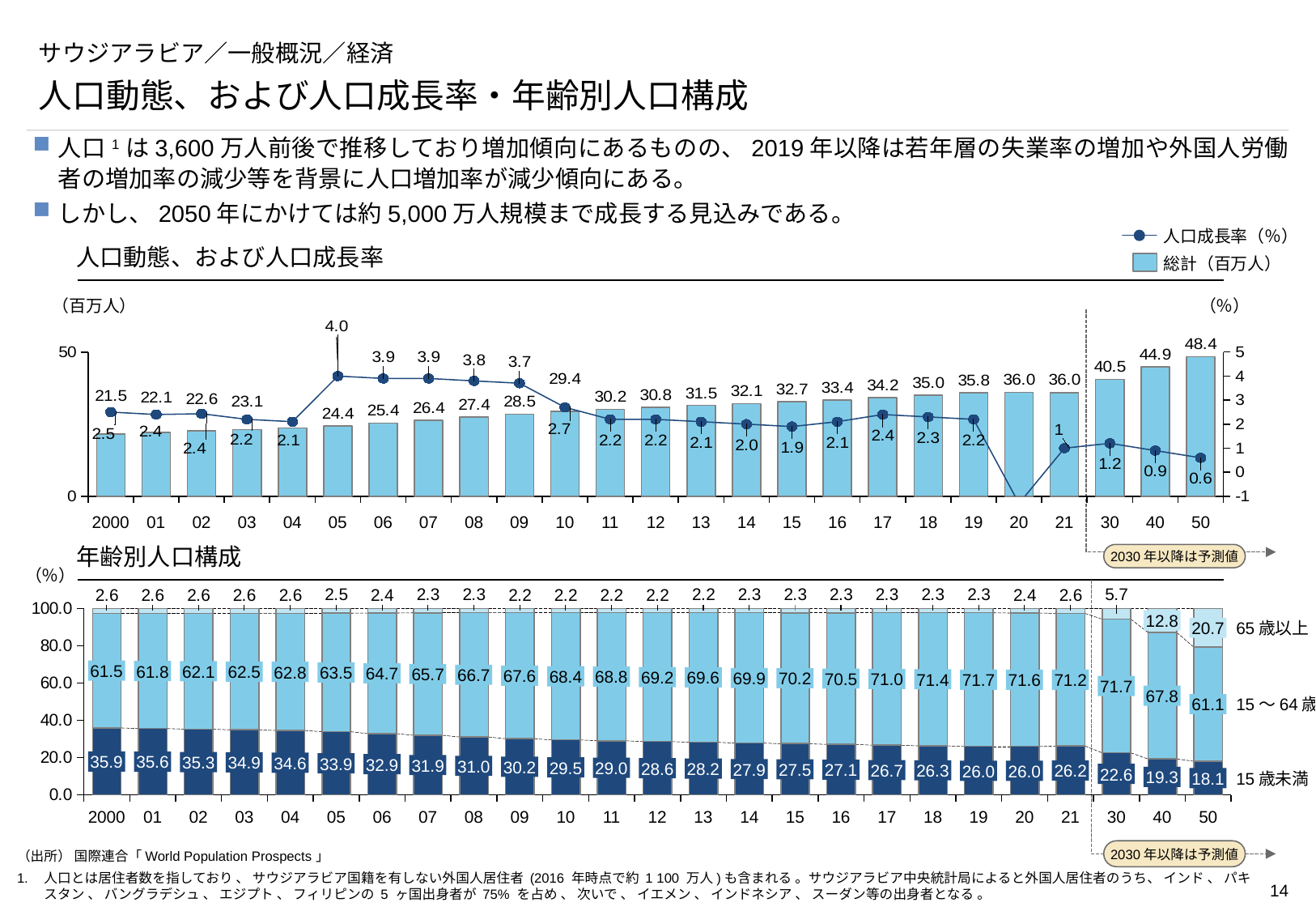
In the bottom chart (年齢別人口構成), what is the share of 65歳以上 in 2050? 20.7 In the top chart (人口動態、および人口成長率), what is the difference between the total population in 2050 and in 2021? 12.4 In the bottom chart (年齢別人口構成), does the share of 15歳未満 rise or fall from 2000 to 2021? fall In the top chart (人口動態、および人口成長率), what is the total population (百万人) shown for 2050? 48.4 What kind of chart is the bottom chart (年齢別人口構成)? stacked bar chart In the top chart (人口動態、および人口成長率), which year has the highest population growth rate? 2005 In the top chart (人口動態、および人口成長率), how many series does the legend list? 2 In the top chart (人口動態、および人口成長率), what is the population growth rate (%) shown for 2005? 4.0 In the top chart (人口動態、および人口成長率), is the total population bar for 2000 greater or less than 50 (百万人)? less In the bottom chart (年齢別人口構成), which is larger in 2000: the share of 15歳未満 or the share of 65歳以上? 15歳未満 In the top chart (人口動態、および人口成長率), what is the total population (百万人) shown for 2010? 29.4 In the bottom chart (年齢別人口構成), what is the share of 15～64歳 in 2021? 71.2